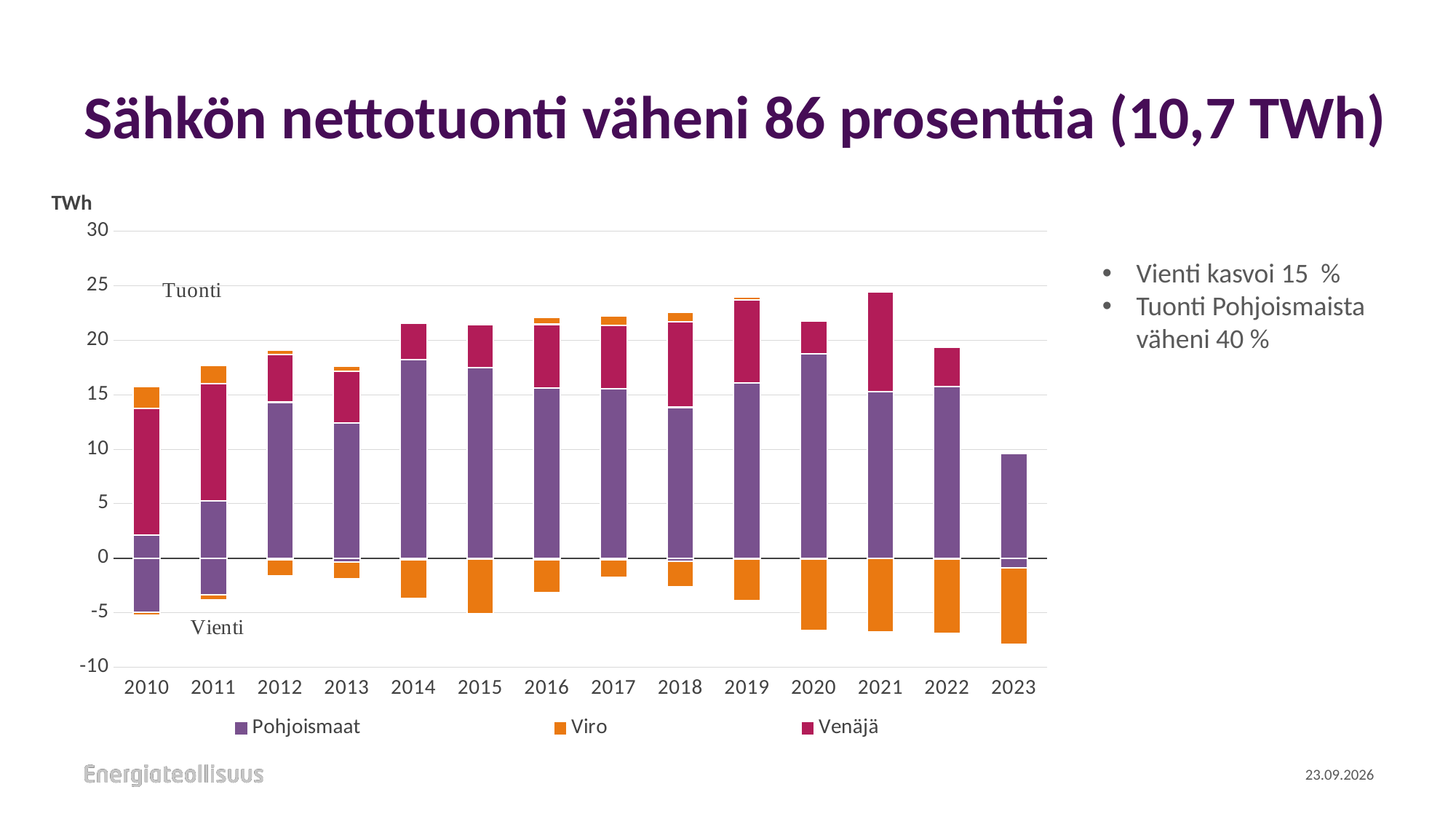
Is the Pohjoismaat import value for 2013 greater or less than 10? greater Is the Pohjoismaat import value for 2020 greater or less than 15? greater How many years are shown on the x axis of the chart? 14 Which is larger, the Venäjä import in 2010 or in 2012? 2010 What unit is shown on the y axis of the chart? TWh What kind of chart is shown on the slide? Stacked bar chart Is the total import (positive stack) for 2021 greater or less than 20? greater Which year has the smallest total import (shortest positive stack)? 2023 Which series are listed in the chart legend? Pohjoismaat, Viro, Venäjä Which is larger, the Pohjoismaat import in 2013 or in 2023? 2013 How many series does the chart legend list? 3